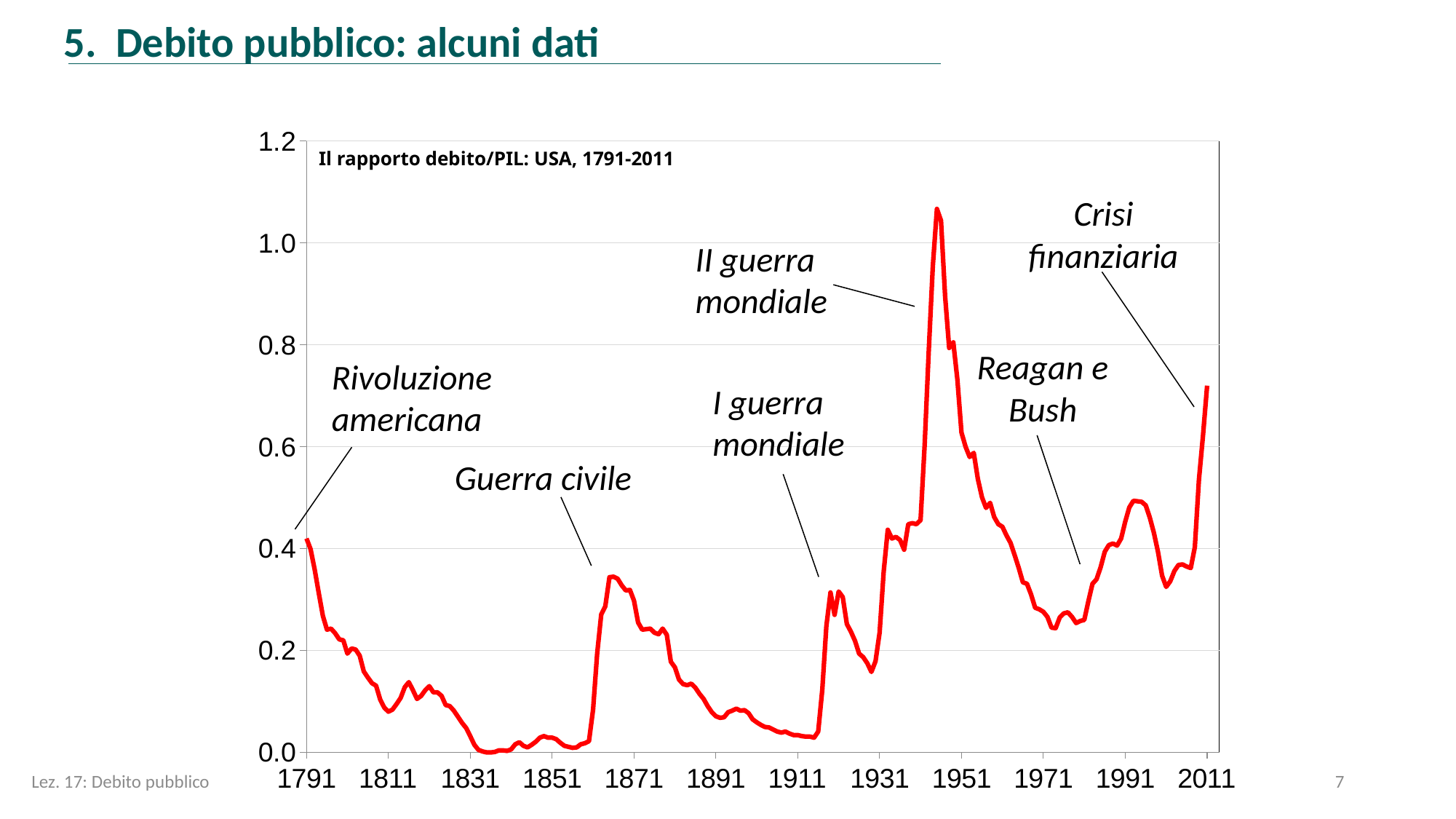
Which is larger: the peak of the debt/GDP ratio at the II guerra mondiale or at the Guerra civile? II guerra mondiale What kind of chart is shown on the slide? line chart What is the title printed inside the chart area? Il rapporto debito/PIL: USA, 1791-2011 What is the first year shown on the x axis? 1791 Does the debt/GDP ratio rise or fall between 1791 and 1831? fall How many historical events are annotated with labels on the chart? 6 Is the value of the debt/GDP ratio around 1835 greater or less than 0.2? less Which annotated event corresponds to the highest peak of the debt/GDP ratio? II guerra mondiale Which is larger: the debt/GDP ratio in 2011 or in 1791? 2011 Is the peak of the debt/GDP ratio at the Guerra civile greater or less than 0.4? less Is the value of the debt/GDP ratio in 2011 greater or less than 0.6? greater